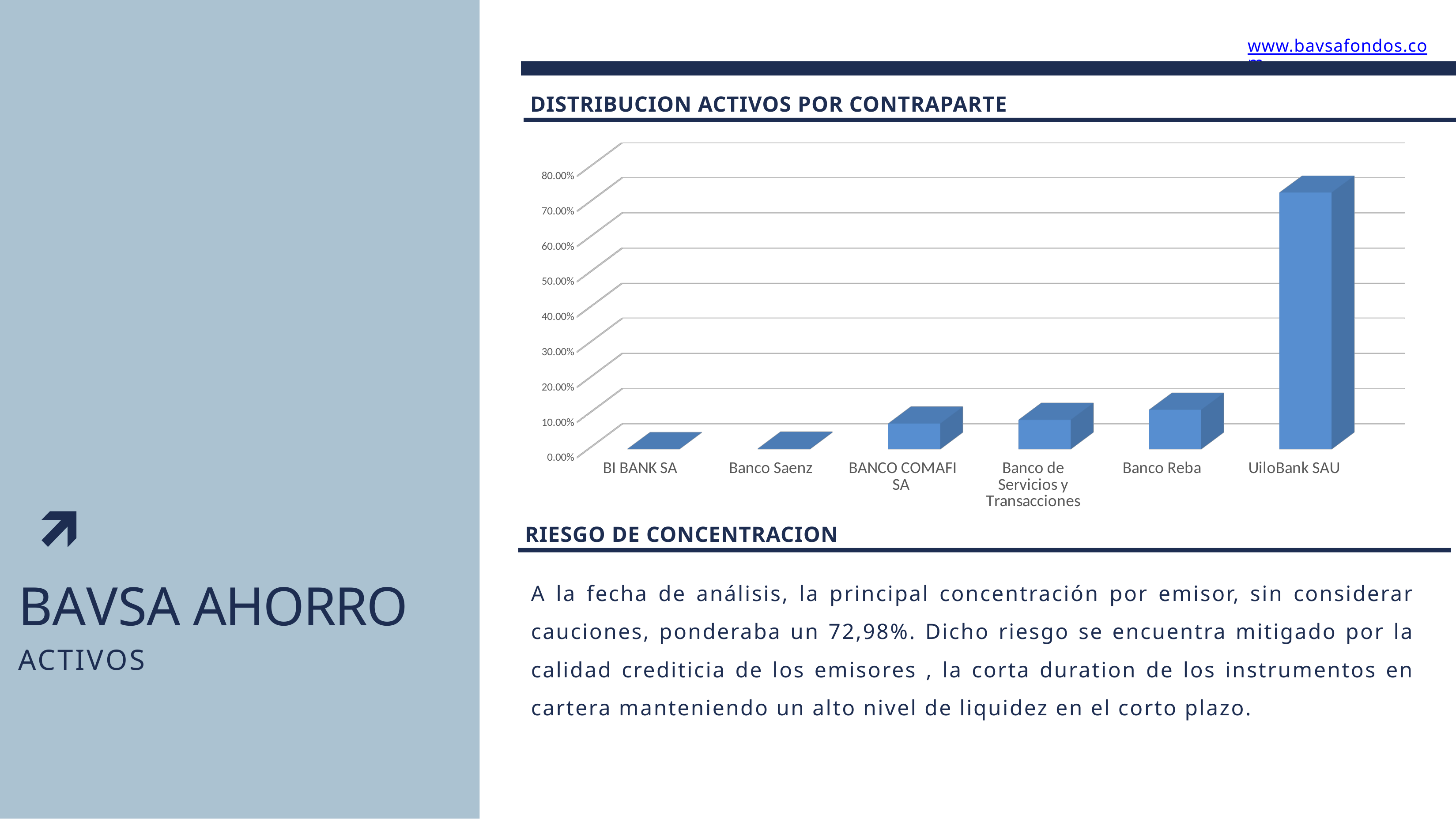
Which is larger, the value for Banco Reba or the value for BANCO COMAFI SA? Banco Reba Is the value for BANCO COMAFI SA greater or less than 20.00%? less Is the value for Banco Reba greater or less than 20.00%? less What is the title of the chart on the slide? DISTRIBUCION ACTIVOS POR CONTRAPARTE What kind of chart is shown on the slide? bar chart How many counterparties (categories) are shown on the x axis of the chart? 6 Which counterparty has the highest value in the chart? UiloBank SAU Is the value for UiloBank SAU greater or less than 60.00%? greater What is the highest tick label shown on the vertical axis of the chart? 80.00% Do the values generally rise or fall from left to right along the x axis? rise Which is larger, the value for UiloBank SAU or the value for Banco de Servicios y Transacciones? UiloBank SAU